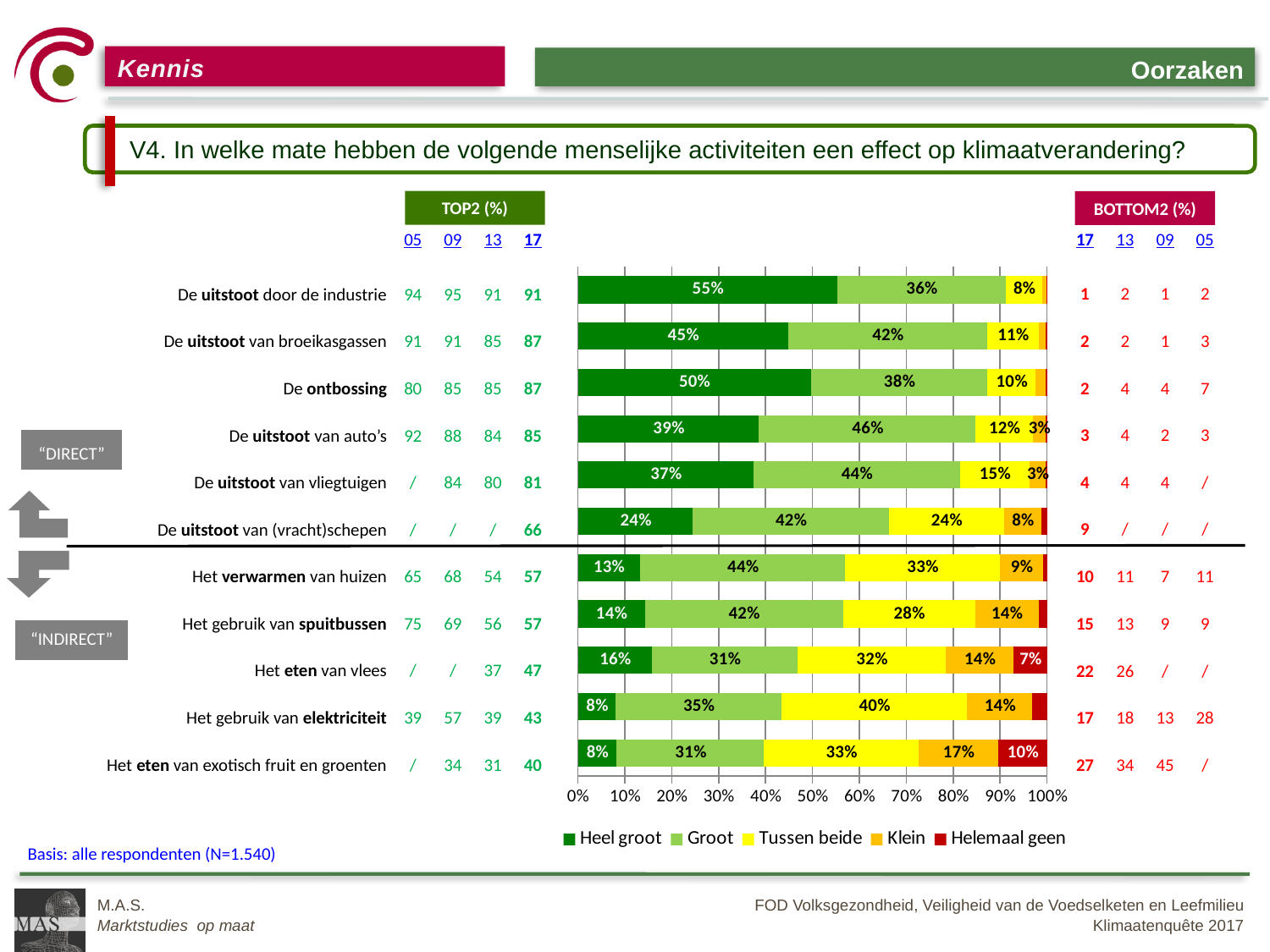
Which legend entry is shown in red? Helemaal geen What is the 'Groot' value for 'De uitstoot van auto's'? 46% What is the difference in percentage points between the 'Heel groot' values for 'De uitstoot door de industrie' and 'De uitstoot van broeikasgassen'? 10 What is the 'Helemaal geen' value for 'Het eten van exotisch fruit en groenten'? 10% Which has a larger 'Klein' value: 'Het eten van exotisch fruit en groenten' or 'Het gebruik van spuitbussen'? Het eten van exotisch fruit en groenten How many categories (activities) are shown in the chart? 11 Which category has the lowest 'Tussen beide' value? De uitstoot door de industrie Which category has the highest 'Heel groot' value? De uitstoot door de industrie What is the 'Tussen beide' value for 'Het gebruik van elektriciteit'? 40% How many series does the legend list? 5 What type of chart is shown on the slide? Stacked bar chart What percentage of respondents answered 'Heel groot' for 'De uitstoot door de industrie'? 55%